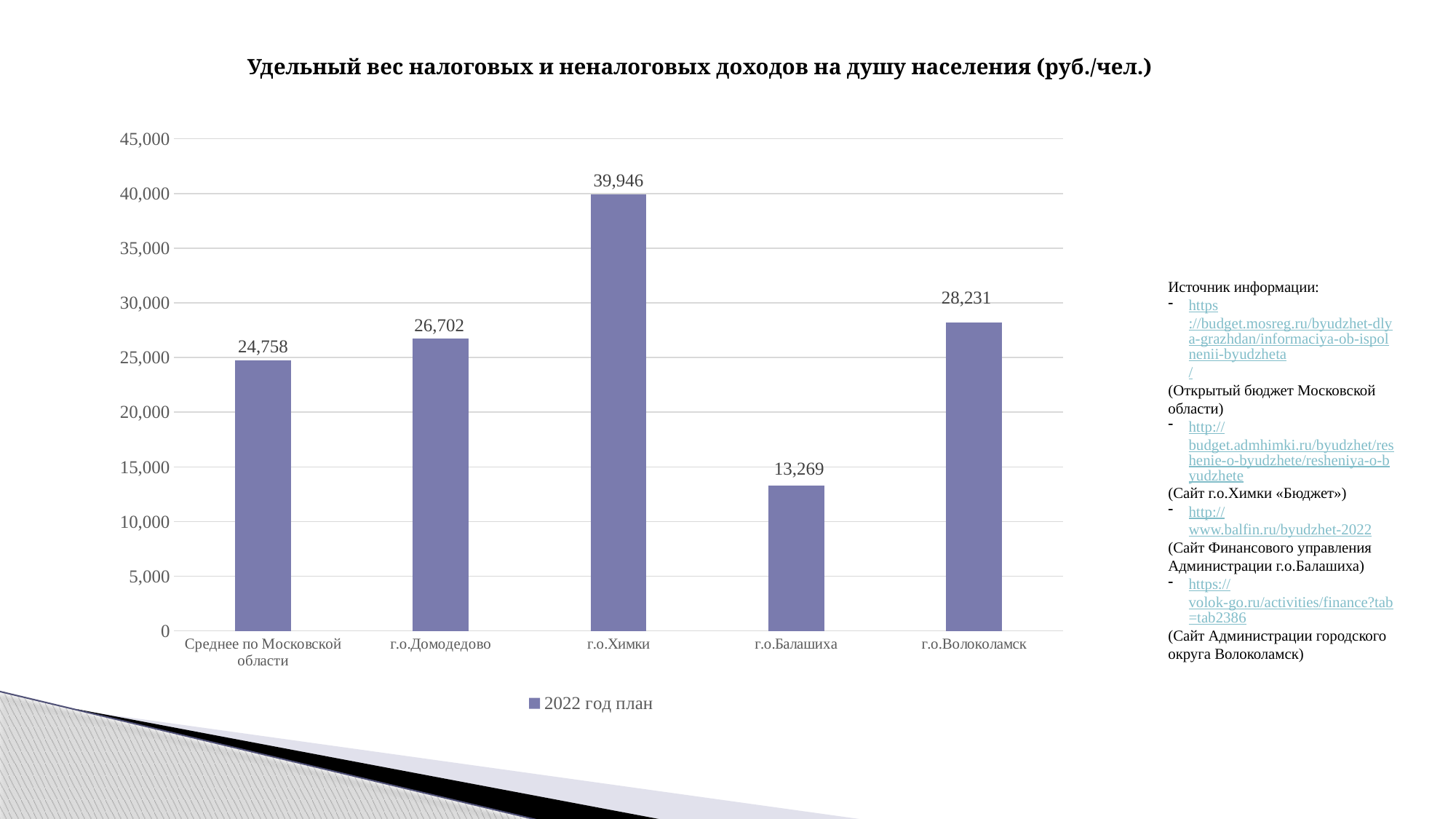
How many categories are shown on the x axis? 5 What is the difference between the values for г.о.Волоколамск and г.о.Домодедово? 1,529 What is the value for Среднее по Московской области? 24,758 Which is larger, the value for г.о.Домодедово or the value for г.о.Волоколамск? г.о.Волоколамск What kind of chart is shown? bar chart What is the value for г.о.Балашиха? 13,269 Is the value for г.о.Балашиха greater or less than 15,000? less How many series does the legend list? 1 What is the value for г.о.Химки? 39,946 Which category has the highest value? г.о.Химки Which category has the lowest value? г.о.Балашиха What is the difference between the values for г.о.Химки and г.о.Балашиха? 26,677